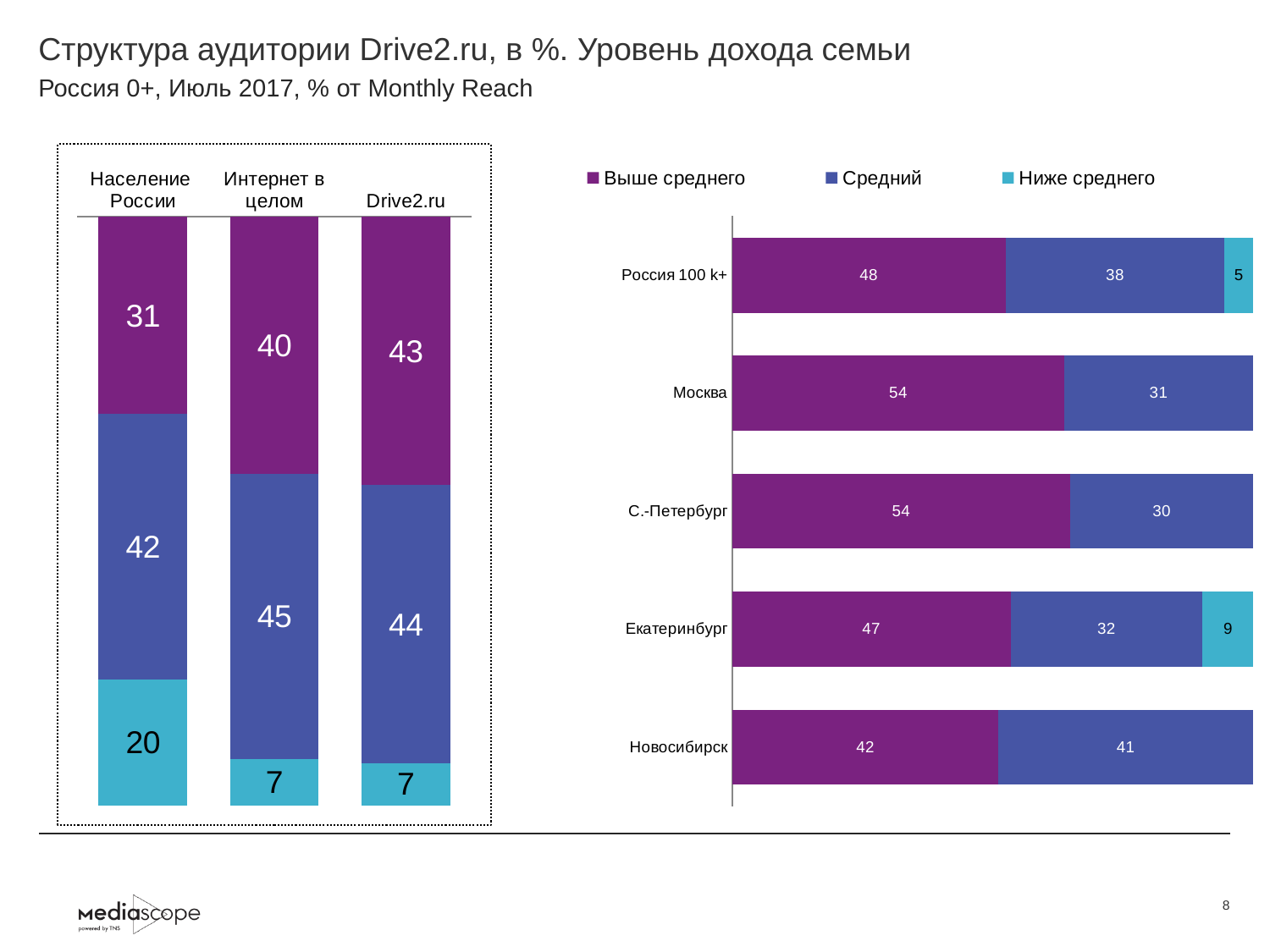
In the right chart, which is larger: the 'Выше среднего' value for Москва or for Екатеринбург? Москва In the left chart, what is the total of the stacked bar for Drive2.ru? 94 In the left chart, which category has the lowest 'Выше среднего' value? Население России In the left chart, what is the difference between the 'Средний' values for Интернет в целом and Население России? 3 In the right chart, what is the 'Ниже среднего' value for Екатеринбург? 9 What type of chart is the right chart? Stacked bar chart In the left chart, what is the 'Выше среднего' value for Drive2.ru? 43 In the left chart, what is the 'Ниже среднего' value for Население России? 20 How many categories are shown on the x axis of the left chart? 3 In the right chart, what is the 'Средний' value for Новосибирск? 41 In the right chart, which city has the highest 'Средний' value? Новосибирск How many series does the legend of the right chart list? 3